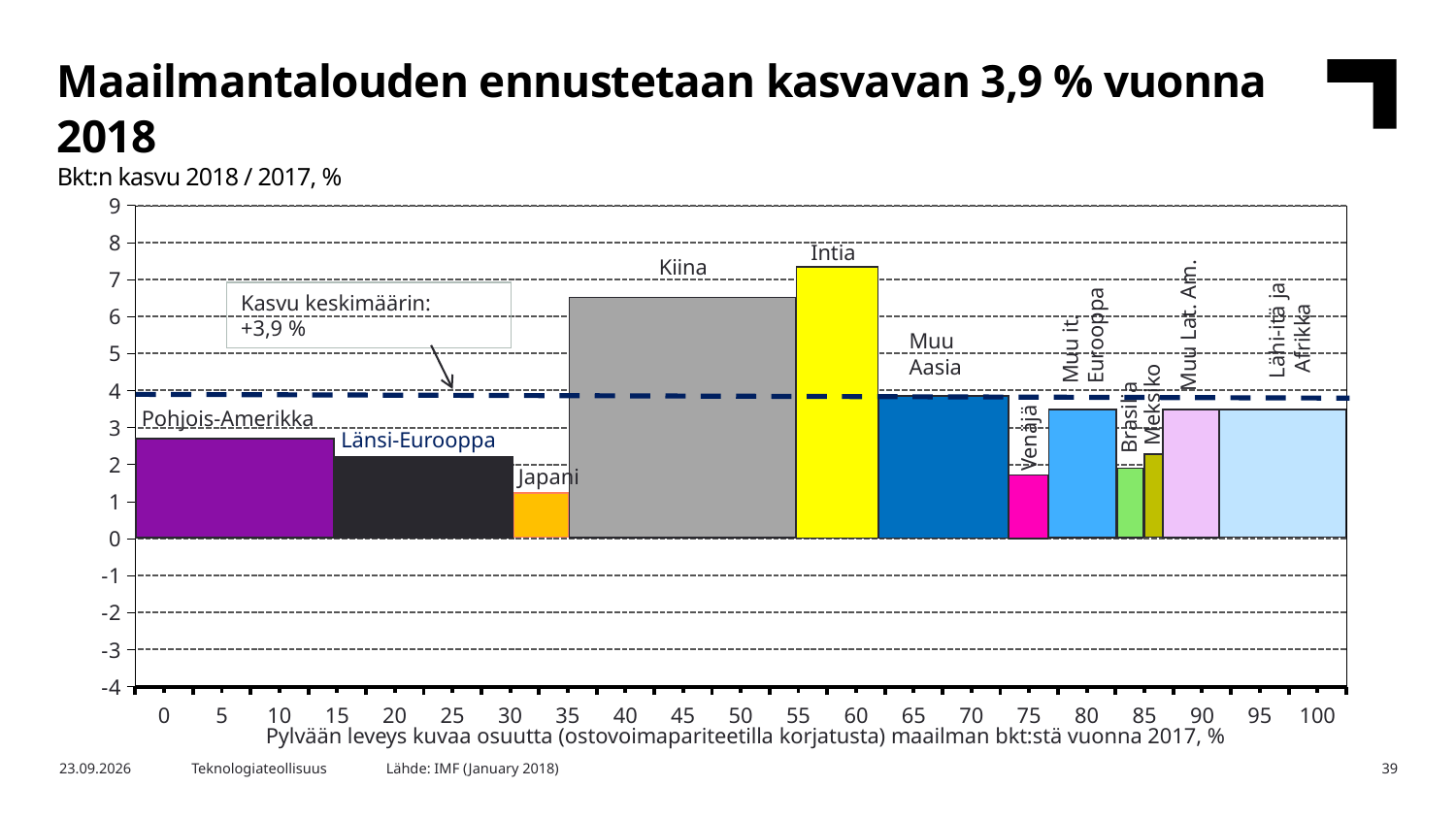
How many regions are shown as bars in the chart? 12 According to the chart's subtitle, what does the chart measure? Bkt:n kasvu 2018 / 2017, % Is the value for Japani greater or less than 2? less What kind of chart is shown on the slide? bar chart Which region has the lowest GDP growth forecast in the chart? Japani Is the value for Kiina greater or less than 6? greater Which has the higher growth forecast, Pohjois-Amerikka or Länsi-Eurooppa? Pohjois-Amerikka Which region has the highest GDP growth forecast in the chart? Intia Is the value for Pohjois-Amerikka greater or less than 3? less What is the average growth (Kasvu keskimäärin) shown in the chart's annotation? +3,9 % Which has the higher growth forecast, Kiina or Intia? Intia